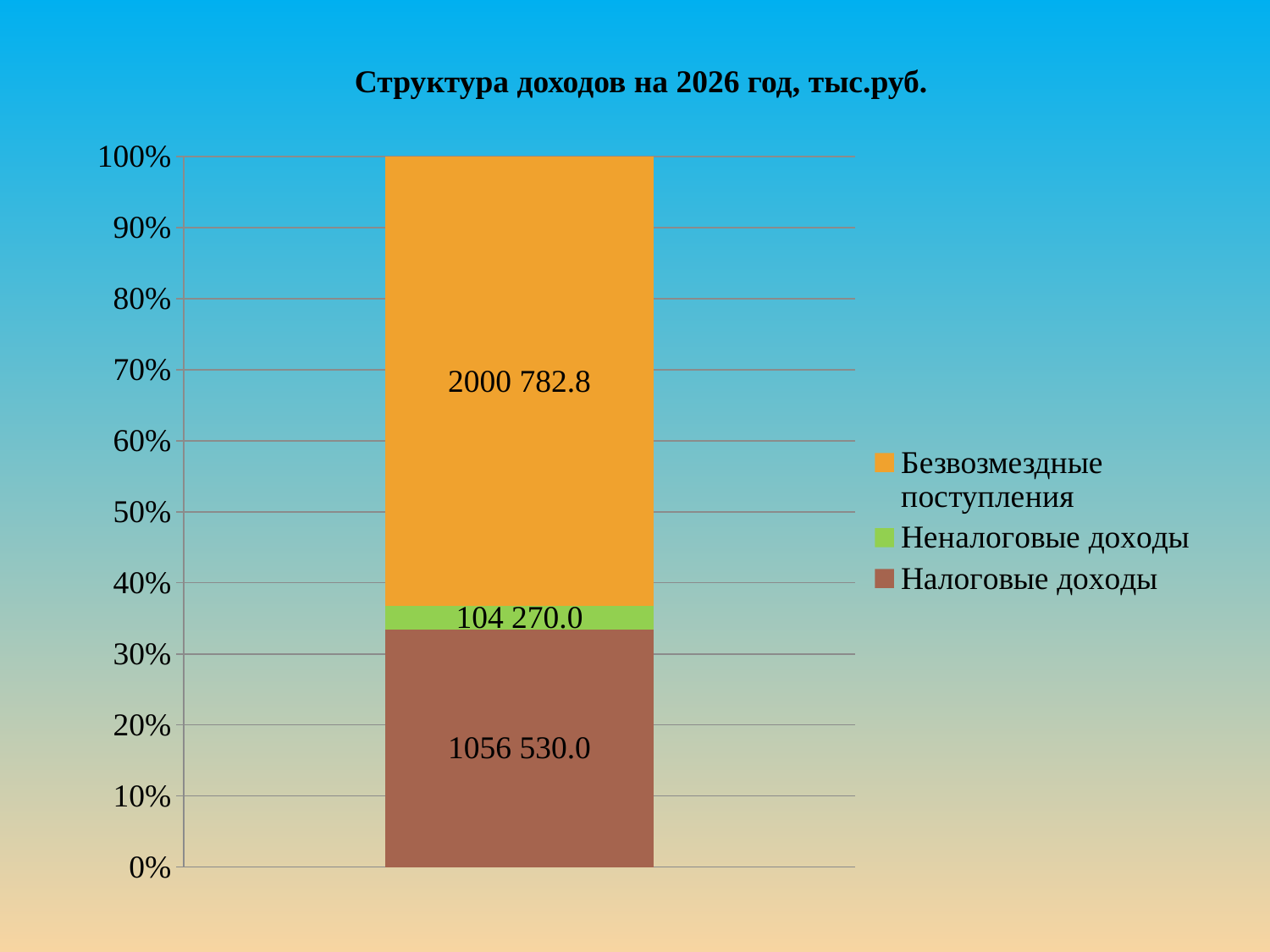
What kind of chart is shown on the slide? Stacked bar chart What is the value for Безвозмездные поступления? 2000 782.8 How many series does the legend list? 3 What is the total of the stacked bar? 3161 582.8 What is the value for Налоговые доходы? 1056 530.0 Is the share of the bar taken by Налоговые доходы greater or less than 40%? less Which series has the largest value? Безвозмездные поступления What is the title of the chart? Структура доходов на 2026 год, тыс.руб. Which is larger, Налоговые доходы or Неналоговые доходы? Налоговые доходы What is the value for Неналоговые доходы? 104 270.0 Which series has the smallest value? Неналоговые доходы What is the difference between Безвозмездные поступления and Налоговые доходы? 944 252.8